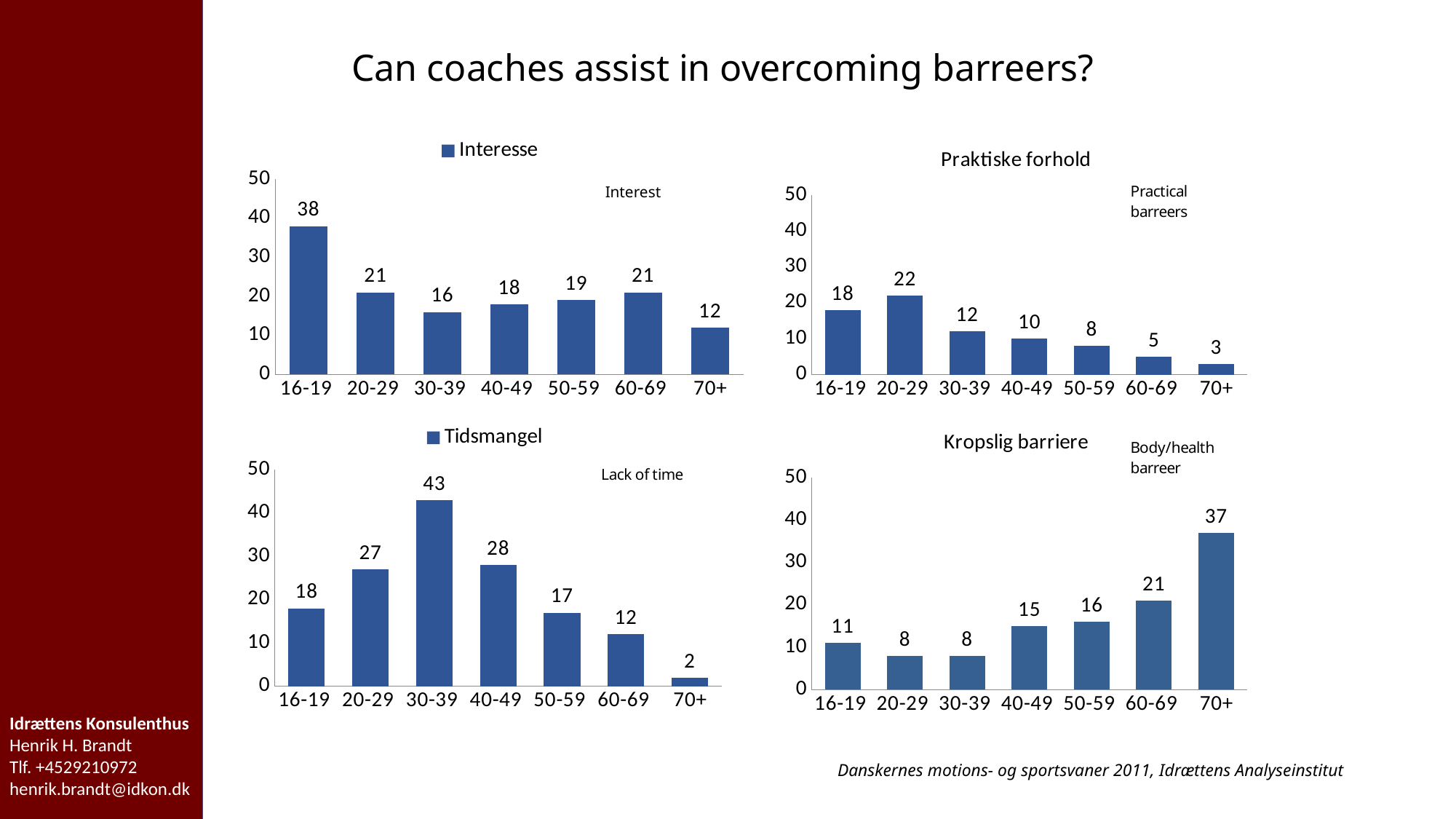
In the Praktiske forhold chart, which age group has the highest value? 20-29 In the Interesse chart, what is the value for the 16-19 age group? 38 In the Interesse chart, what is the difference between the values for 16-19 and 70+? 26 In the Kropslig barriere chart, what is the value for the 70+ age group? 37 In the Tidsmangel chart, which age group has the lowest value? 70+ In the Praktiske forhold chart, which is larger: the value for 16-19 or the value for 60-69? 16-19 In the Tidsmangel chart, what is the difference between the values for 30-39 and 40-49? 15 In the Kropslig barriere chart, what is the value for the 40-49 age group? 15 How many age groups are shown in the Interesse chart? 7 In the Praktiske forhold chart, do the values generally rise or fall from the 20-29 group to the 70+ group? Fall What kind of chart is the Kropslig barriere chart? Bar chart What is the title of the bottom-left chart? Tidsmangel